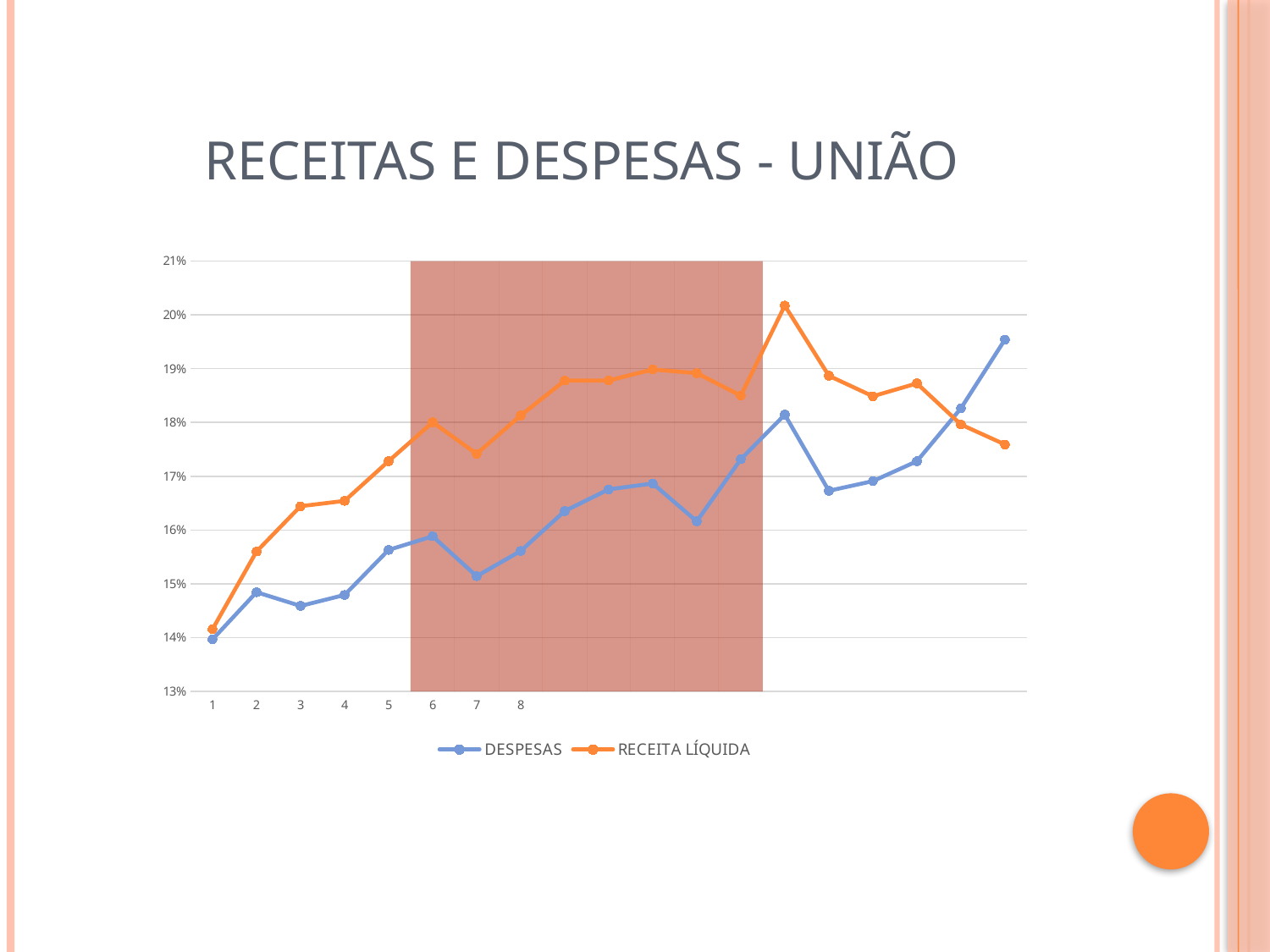
At point 4, which series has the larger value, DESPESAS or RECEITA LÍQUIDA? RECEITA LÍQUIDA What kind of chart is shown on the slide? line chart What is the title of the slide? RECEITAS E DESPESAS - UNIÃO Is the value of DESPESAS at point 2 greater or less than 15%? less Which series is drawn in orange? RECEITA LÍQUIDA How many series does the legend list? 2 Is the value of RECEITA LÍQUIDA at point 5 greater or less than 17%? greater Is the value of RECEITA LÍQUIDA at point 2 greater or less than 15%? greater Does the RECEITA LÍQUIDA series rise or fall from point 1 to point 6? rise At which labelled point does DESPESAS have its lowest value? 1